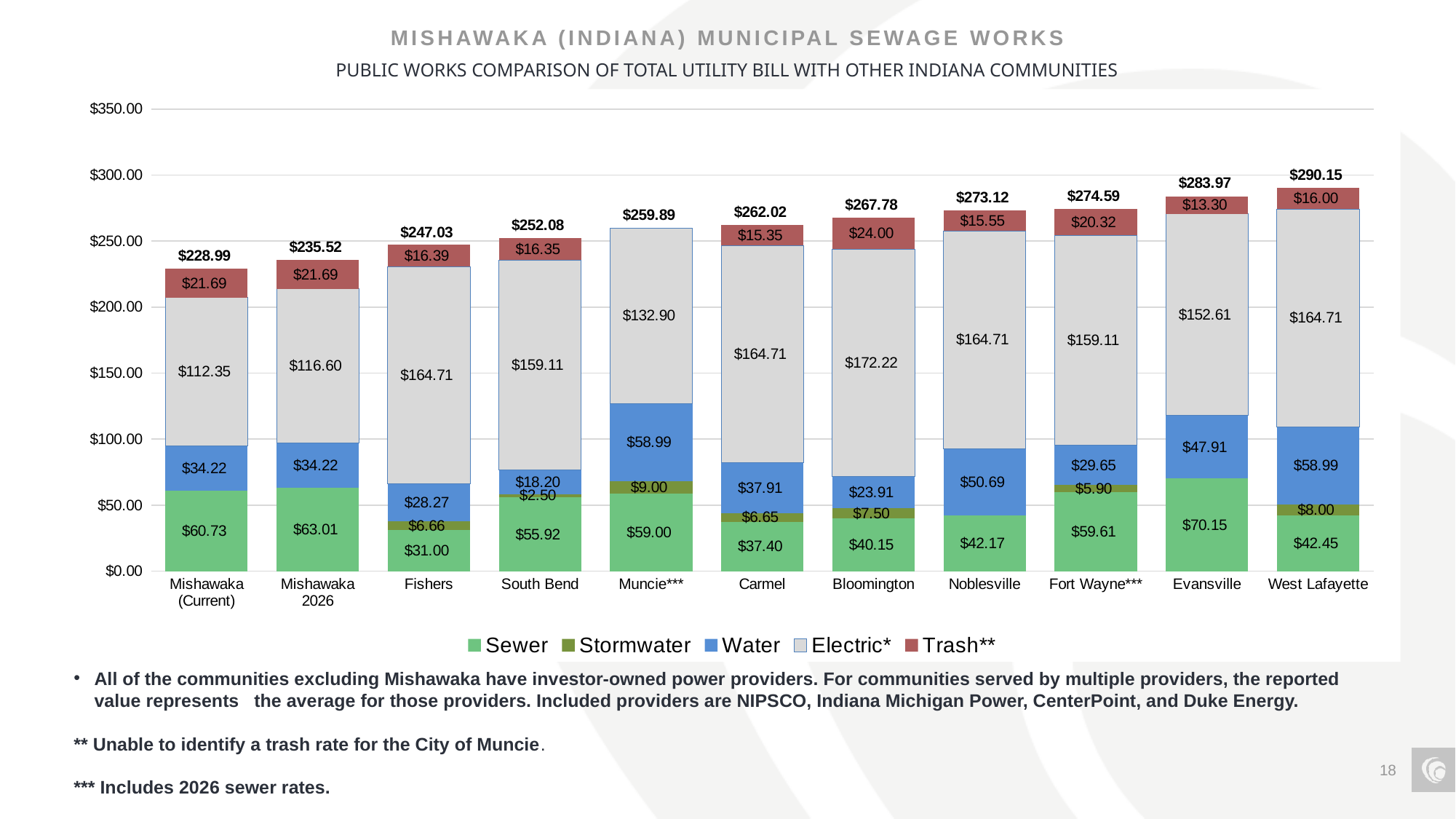
How many series does the legend list? 5 Which is larger, the Water value for Noblesville or the Water value for Evansville? Noblesville How many communities are shown on the x axis? 11 What is the Trash value for Fort Wayne***? $20.32 What is the Sewer value for Evansville? $70.15 Which community has the highest total utility bill? West Lafayette Do the total utility bills rise or fall from left to right along the x axis? Rise What is the total utility bill shown for West Lafayette? $290.15 Which community has the lowest total utility bill? Mishawaka (Current) What is the difference between the total bills for Mishawaka 2026 and Mishawaka (Current)? $6.53 What kind of chart is shown on the slide? Stacked bar chart What is the Electric value for Bloomington? $172.22